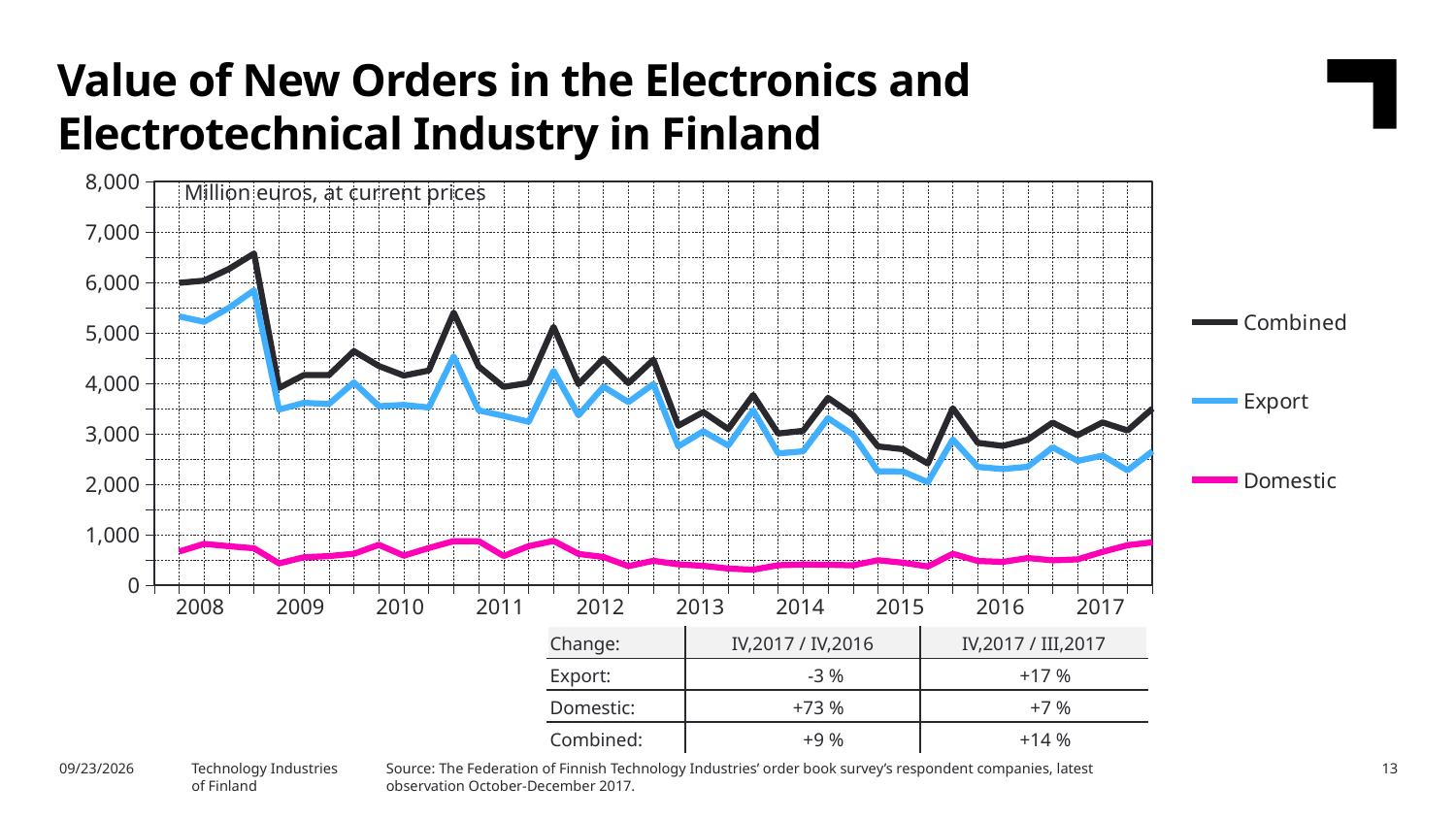
Does the Combined series overall rise or fall from 2008 to 2017? fall What kind of chart is shown on the slide? Line chart How many series does the legend list? 3 How many years are labelled on the x axis? 10 What unit is stated in the label inside the chart area? Million euros, at current prices Which series are listed in the legend? Combined, Export, Domestic Which series is larger in 2016, Export or Domestic? Export Is the value of the Combined series at the start of 2008 greater or less than 5,000? greater Is the value of the Export series at the end of 2017 greater or less than 3,000? less Which series has the lowest values throughout the chart? Domestic Is the value of the Domestic series in 2017 greater or less than 1,000? less In which year does the Combined series reach its highest value? 2008